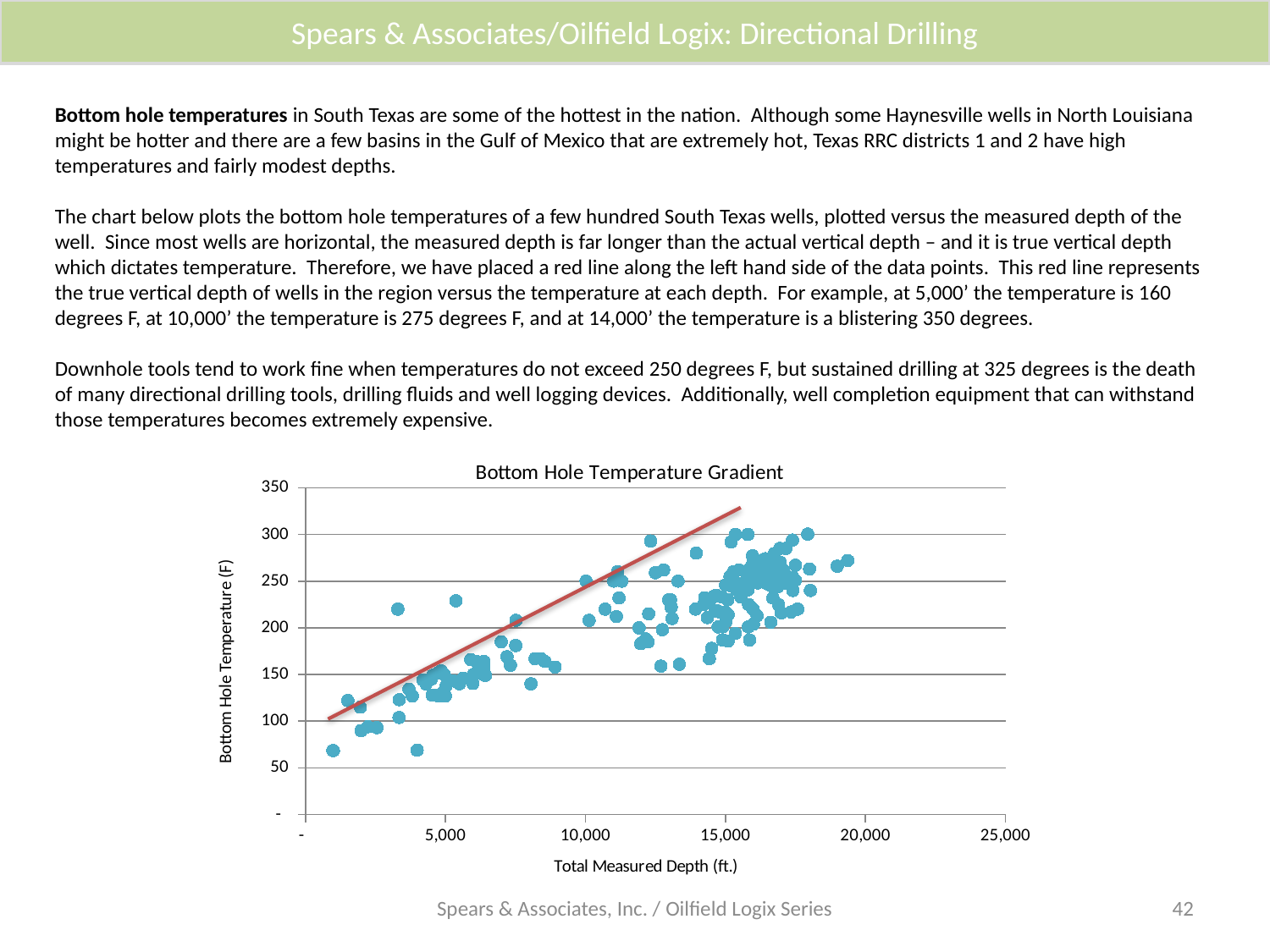
Do bottom hole temperatures generally rise or fall as total measured depth increases along the x axis? Rise Is the highest plotted bottom hole temperature greater or less than 350? less What is the label of the chart's x axis? Total Measured Depth (ft.) Is the lowest plotted bottom hole temperature greater or less than 100? less Is the largest total measured depth plotted greater or less than 15,000? greater What kind of chart is shown on the slide? Scatter chart What is the title of the chart? Bottom Hole Temperature Gradient